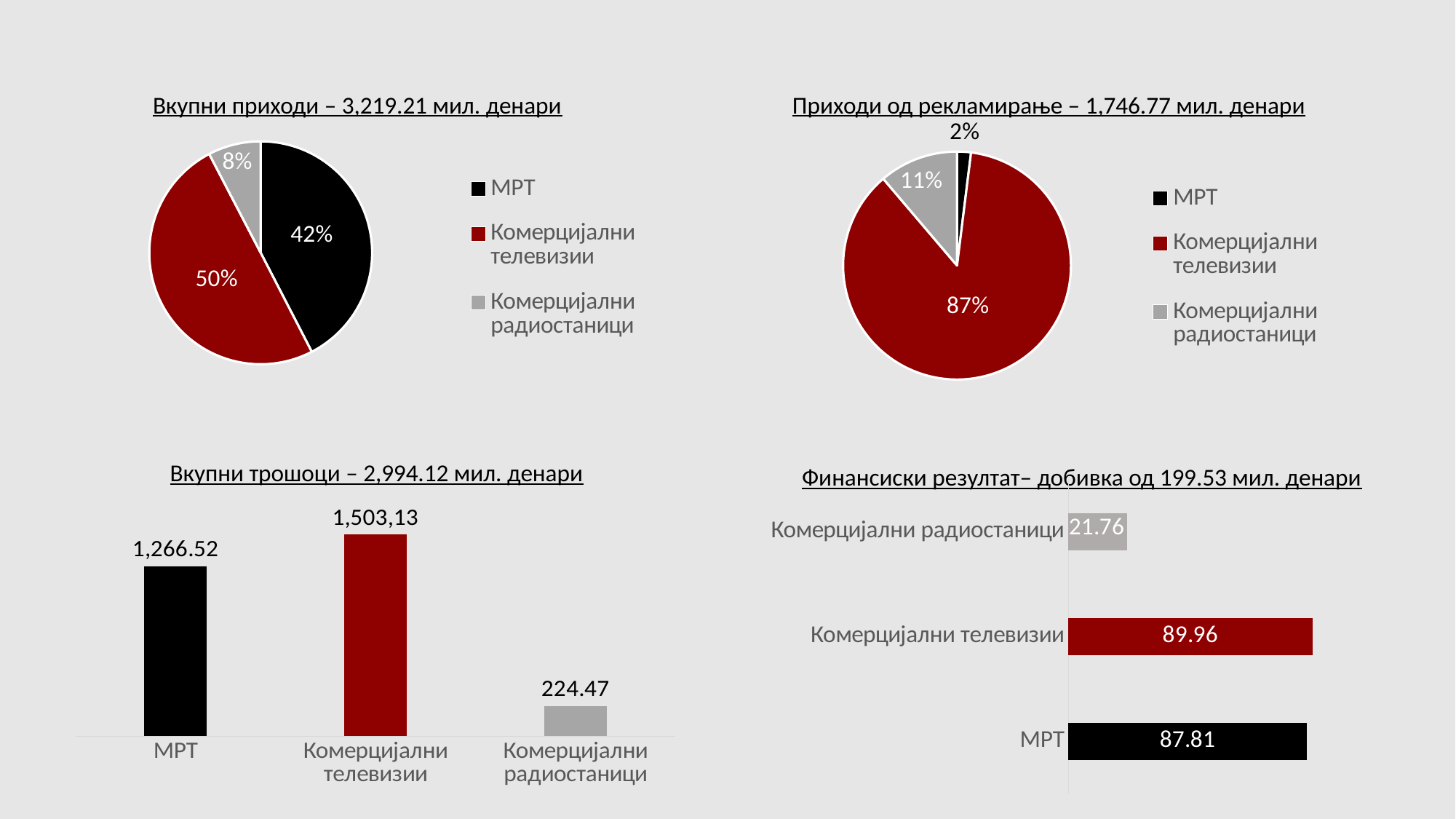
In the chart titled "Финансиски резултат– добивка од 199.53 мил. денари", what is the value for Комерцијални радиостаници? 21.76 In the chart titled "Финансиски резултат– добивка од 199.53 мил. денари", which is larger, the value for Комерцијални телевизии or the value for МРТ? Комерцијални телевизии In the chart titled "Приходи од рекламирање – 1,746.77 мил. денари", which category has the smallest slice? МРТ In the chart titled "Вкупни трошоци – 2,994.12 мил. денари", how many categories are shown? 3 In the chart titled "Приходи од рекламирање – 1,746.77 мил. денари", what kind of chart is shown? pie chart In the chart titled "Вкупни трошоци – 2,994.12 мил. денари", which category has the lowest value? Комерцијални радиостаници In the chart titled "Финансиски резултат– добивка од 199.53 мил. денари", what kind of chart is shown? bar chart In the chart titled "Вкупни приходи – 3,219.21 мил. денари", what share of the pie does МРТ have? 42% In the chart titled "Вкупни приходи – 3,219.21 мил. денари", which category has the largest slice? Комерцијални телевизии In the chart titled "Вкупни трошоци – 2,994.12 мил. денари", what is the value for МРТ? 1,266.52 In the chart titled "Приходи од рекламирање – 1,746.77 мил. денари", what share does Комерцијални радиостаници have? 11% In the chart titled "Вкупни трошоци – 2,994.12 мил. денари", what is the difference between the values for МРТ and Комерцијални радиостаници? 1,042.05